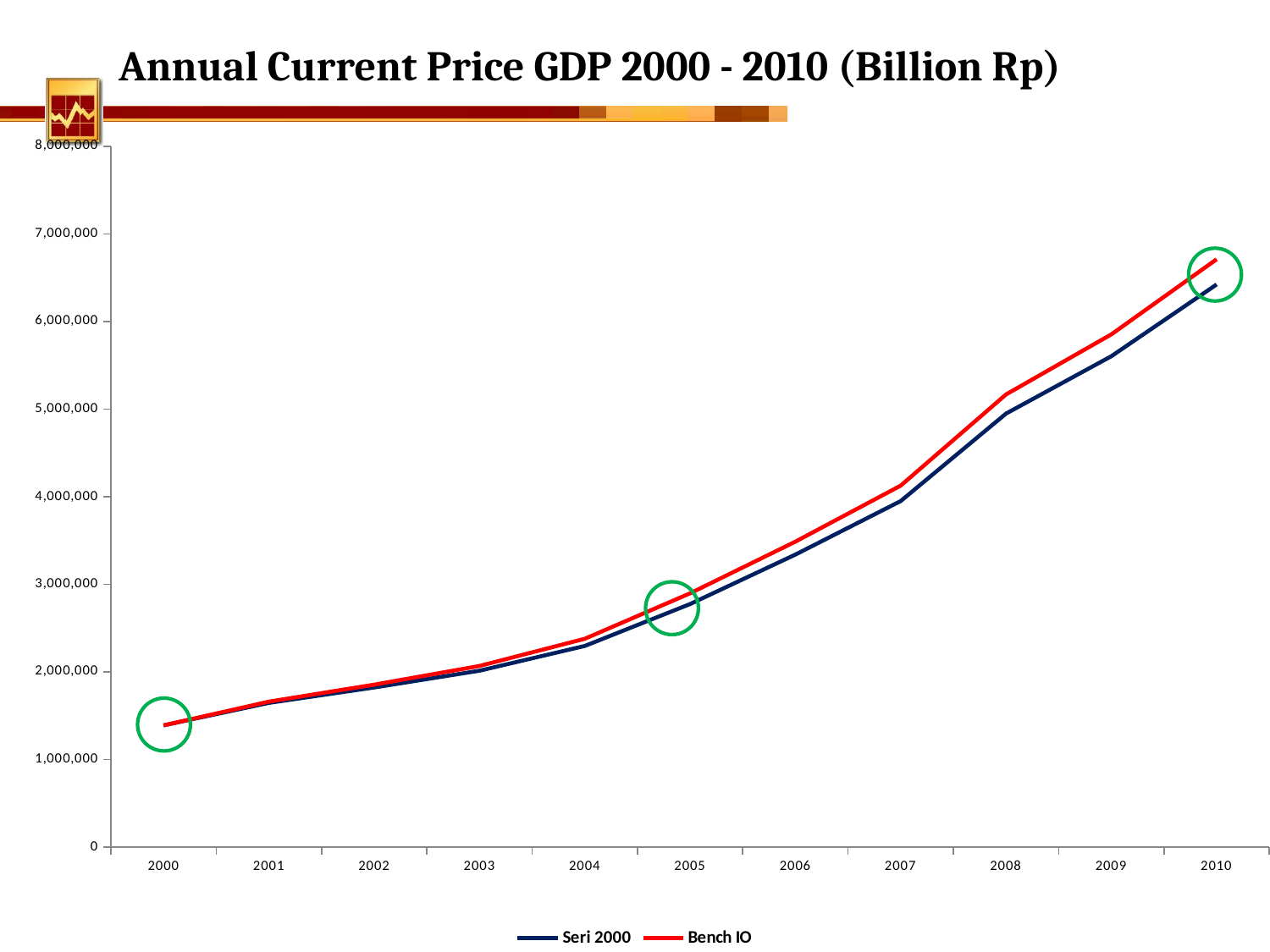
Is the value for Seri 2000 in 2005 greater or less than 3,000,000? less How many series does the legend list? 2 Is the value for Bench IO in 2000 greater or less than 2,000,000? less In which year is the Seri 2000 series at its lowest value? 2000 What colour is the line for the Bench IO series? red What kind of chart is shown on the slide? line chart In 2010, which series has the larger value, Seri 2000 or Bench IO? Bench IO What is the title of the chart? Annual Current Price GDP 2000 - 2010 (Billion Rp) Is the value for Bench IO in 2010 greater or less than 6,000,000? greater How many years are plotted along the x axis? 11 In which year does the Bench IO series reach its highest value? 2010 Do the values of the Seri 2000 series rise or fall from 2000 to 2010? rise